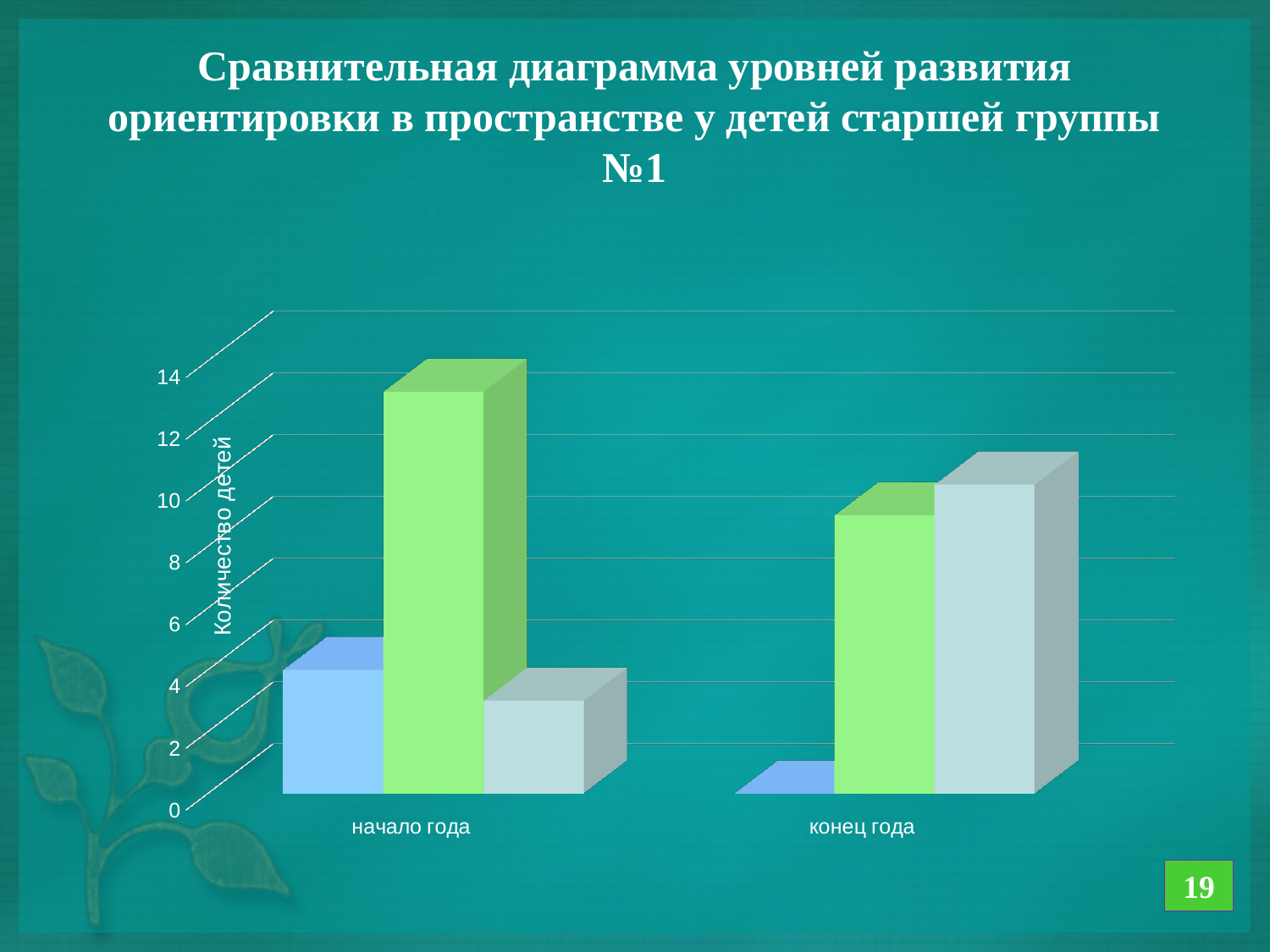
Is the value of the blue bar for начало года greater or less than 6? less How many categories are shown on the x axis of the chart? 2 What kind of chart is shown on the slide? bar chart Does the green bar rise or fall from начало года to конец года? fall What is the title of the vertical axis of the chart? Количество детей Is the value of the light grey bar for начало года greater or less than 4? less Is the value of the green bar for конец года greater or less than 8? greater What are the two category labels on the x axis of the chart? начало года, конец года For начало года, which is larger: the green bar or the light grey bar? the green bar